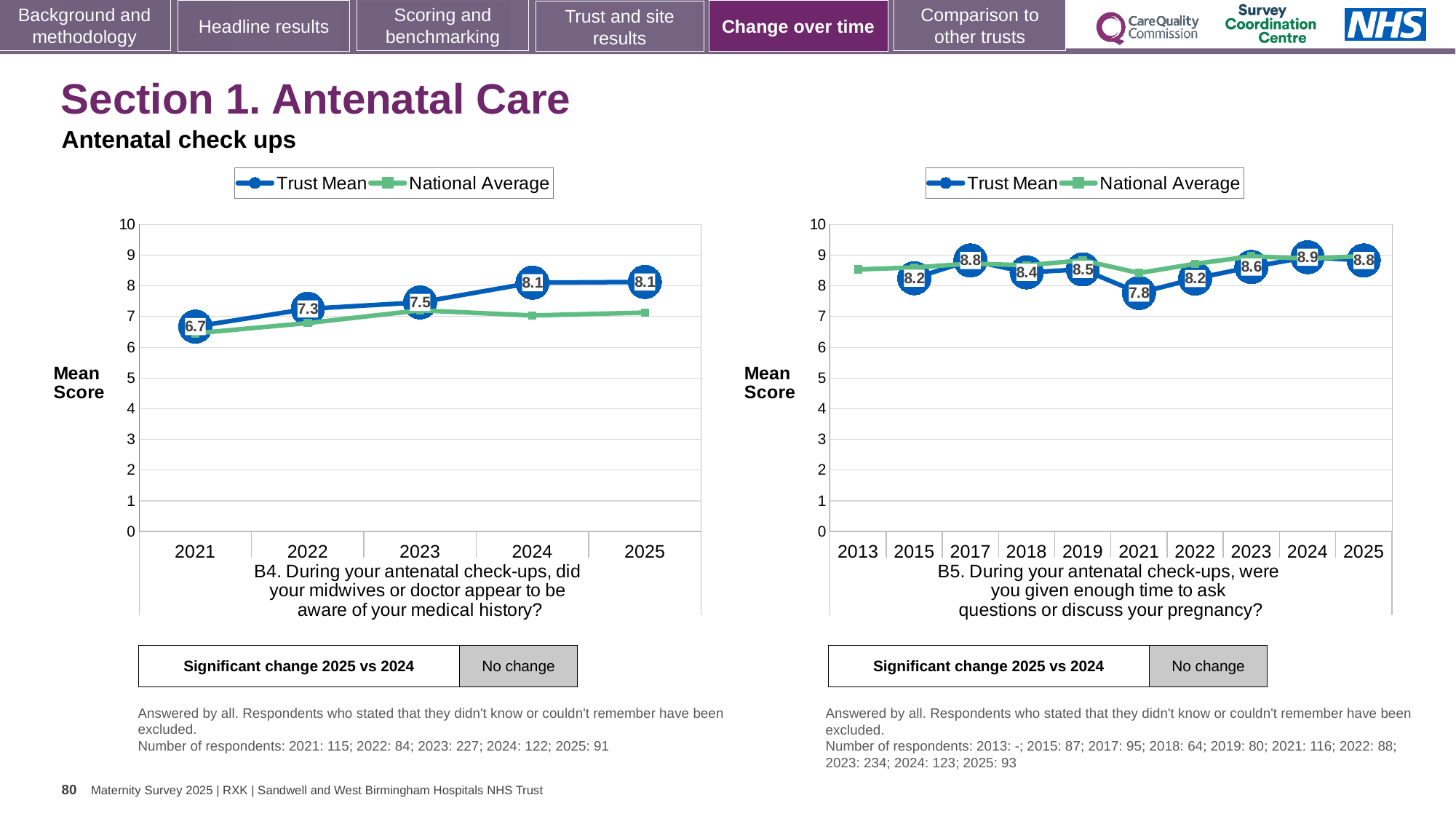
In the B5 chart (right), which is larger, the Trust Mean for 2017 or for 2018? 2017 In the B5 chart (right), which year has the highest Trust Mean? 2024 In the B4 chart (left), which year has the lowest Trust Mean? 2021 In the B4 chart (left), does the Trust Mean rise or fall from 2021 to 2025? rise In the B4 chart (left), what is the difference between the Trust Mean for 2023 and 2021? 0.8 In the B4 chart (left), is the National Average for 2025 greater or less than 8? less In the B4 chart (left), what is the Trust Mean for 2021? 6.7 What type of chart is the B4 chart (left)? line chart In the B5 chart (right), what is the Trust Mean for 2021? 7.8 How many years are shown on the x axis of the B5 chart (right)? 10 In the B4 chart (left), what is the Trust Mean for 2024? 8.1 In the B5 chart (right), which year has the lowest Trust Mean? 2021